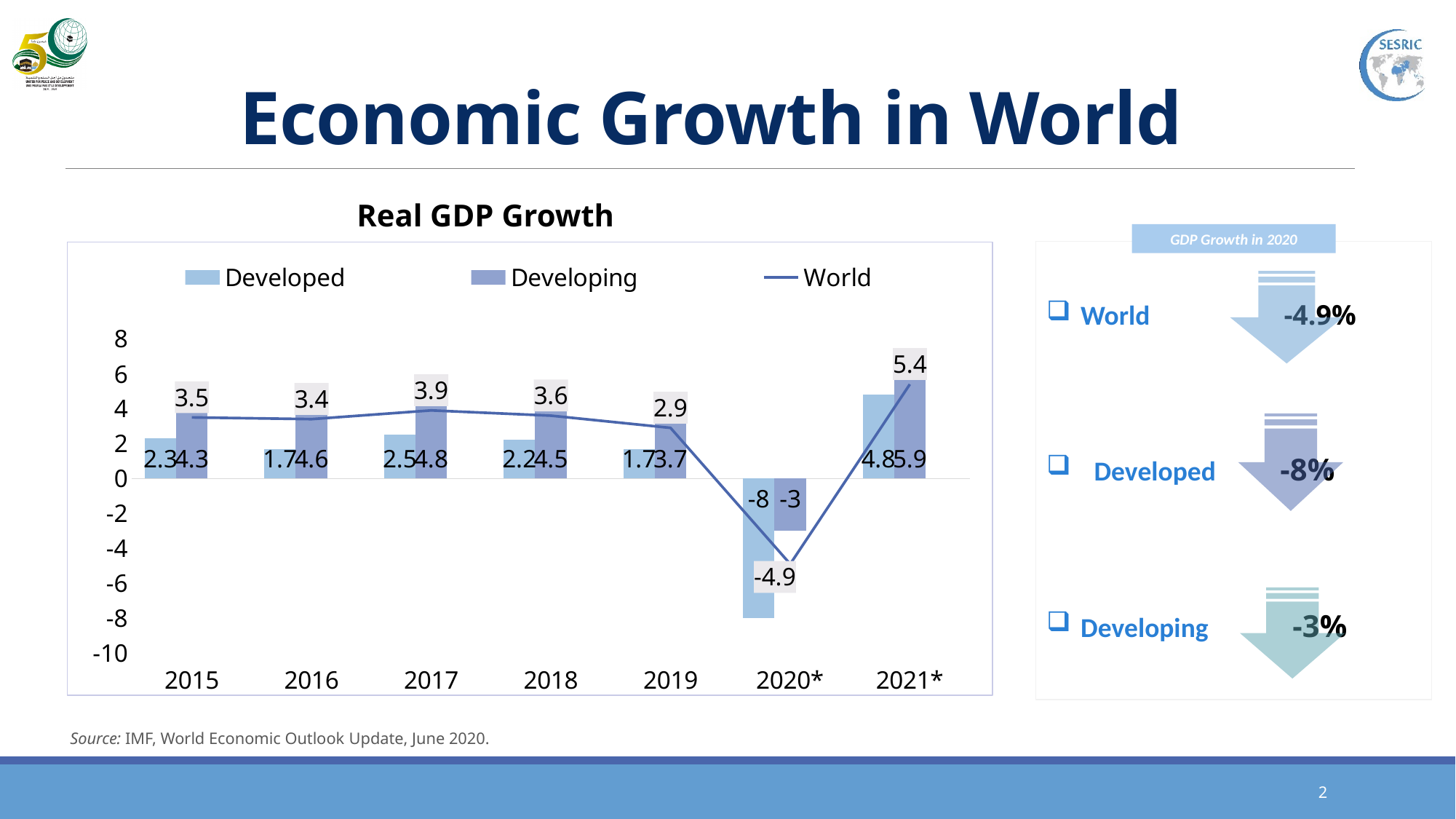
In which year does the World series reach its lowest value? 2020* What is the title of the chart on the slide? Real GDP Growth How many series does the legend of the Real GDP Growth chart list? 3 What is the World value for 2021* in the Real GDP Growth chart? 5.4 What is the World value for 2017 in the Real GDP Growth chart? 3.9 How many years are shown on the x axis of the Real GDP Growth chart? 7 Which is larger, the World value in 2018 or the World value in 2019? 2018 Does the World line rise or fall from 2017 to 2020*? fall What is the Developing value for 2020* in the Real GDP Growth chart? -3 What is the Developed value for 2020* in the Real GDP Growth chart? -8 What is the difference between the Developing and Developed values in 2020*? 5 In which year does the World series reach its highest value? 2021*